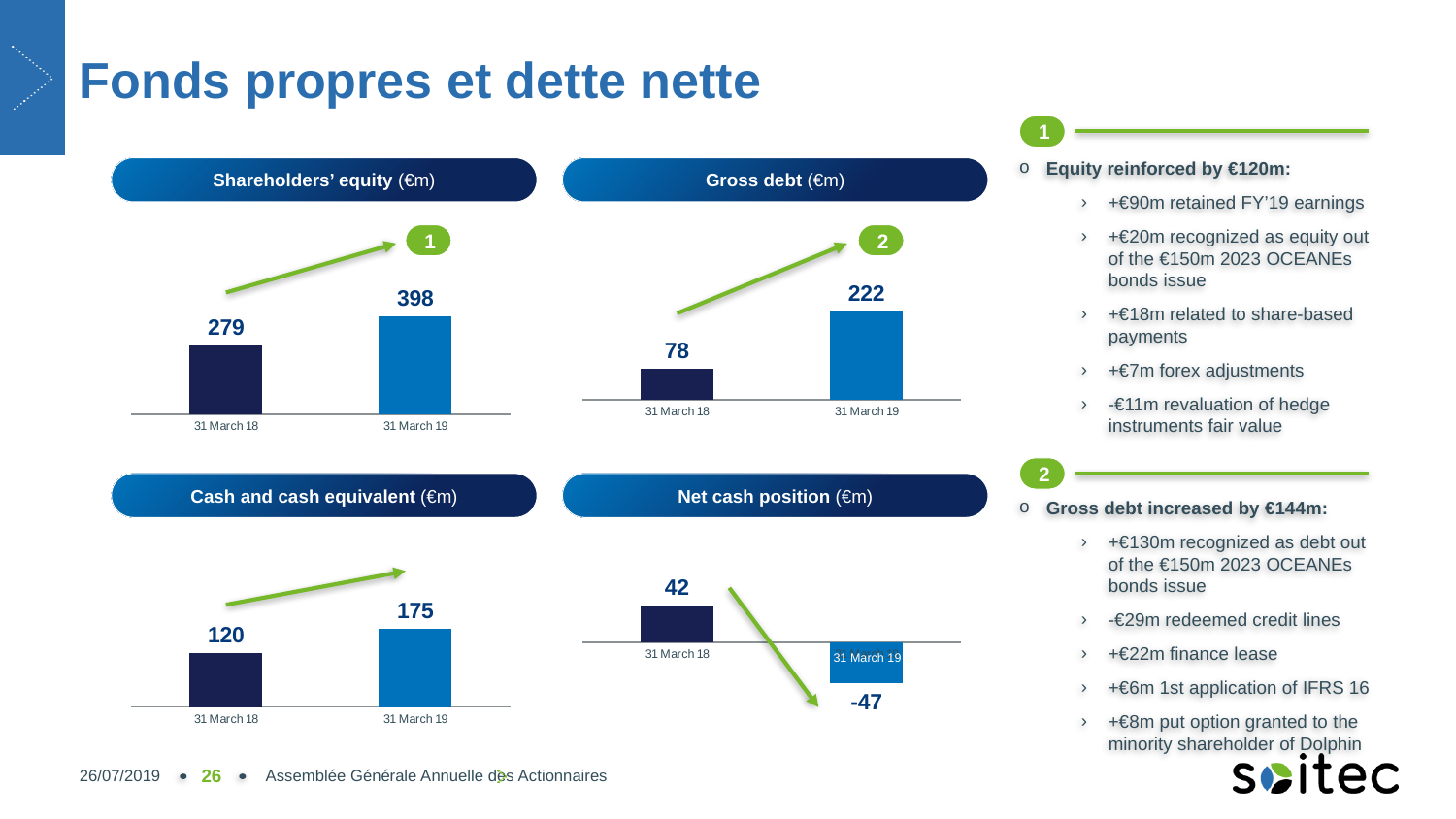
In the Shareholders' equity chart, what is the difference between the 31 March 19 and 31 March 18 values? 119 In the Cash and cash equivalent chart, what is the value for 31 March 18? 120 What type of chart is the Shareholders' equity chart? bar chart In the Gross debt chart, what is the difference between the 31 March 19 and 31 March 18 values? 144 In the Cash and cash equivalent chart, which date has the higher value? 31 March 19 In the Net cash position chart, what is the value for 31 March 19? -47 In the Shareholders' equity chart, what is the value for 31 March 19? 398 In the Net cash position chart, what is the value for 31 March 18? 42 In the Gross debt chart, what is the value for 31 March 19? 222 How many bars are in the Gross debt chart? 2 In the Net cash position chart, do the values rise or fall from 31 March 18 to 31 March 19? fall In the Shareholders' equity chart, what is the value for 31 March 18? 279